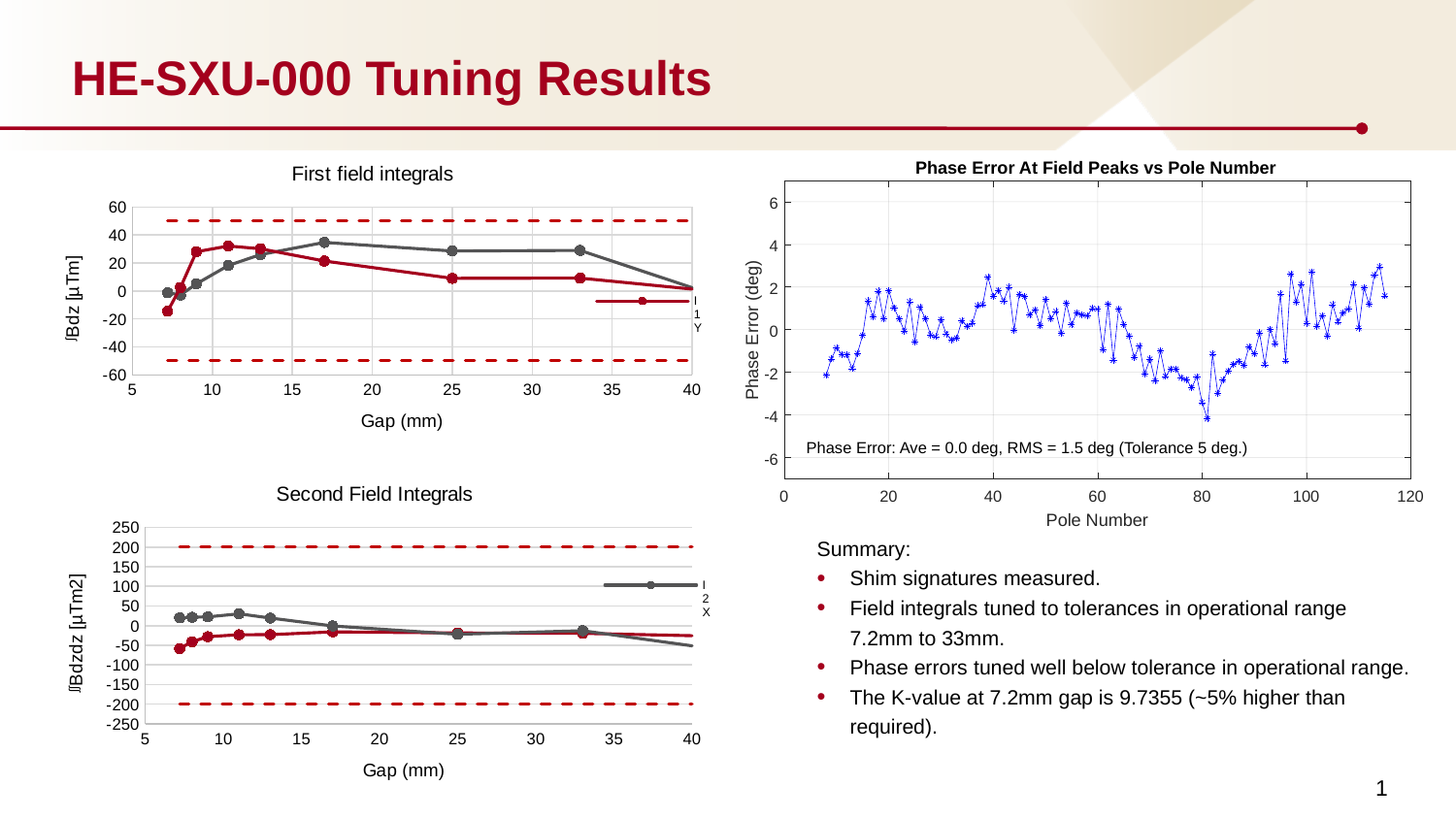
In the 'Phase Error At Field Peaks vs Pole Number' chart, what is the RMS phase error stated in the annotation? 1.5 deg In the 'Second Field Integrals' chart, does the grey series rise or fall between a gap of 33 mm and 40 mm? fall In the 'Phase Error At Field Peaks vs Pole Number' chart, what is the average phase error stated in the annotation? 0.0 deg In the 'Second Field Integrals' chart, is the value of the grey series at a gap of about 11 mm greater or less than 0? greater In the 'First field integrals' chart, does the red series rise or fall between a gap of 25 mm and 40 mm? fall What kind of chart is the 'First field integrals' chart? line chart In the 'First field integrals' chart, is the value of the grey series at a gap of about 17 mm greater or less than 20? greater In the 'Phase Error At Field Peaks vs Pole Number' chart, what tolerance is stated in the annotation? 5 deg In the 'First field integrals' chart, is the value of the red series at a gap of about 7 mm greater or less than 0? less What is the x-axis label of the 'Second Field Integrals' chart? Gap (mm) What is the x-axis label of the 'Phase Error At Field Peaks vs Pole Number' chart? Pole Number